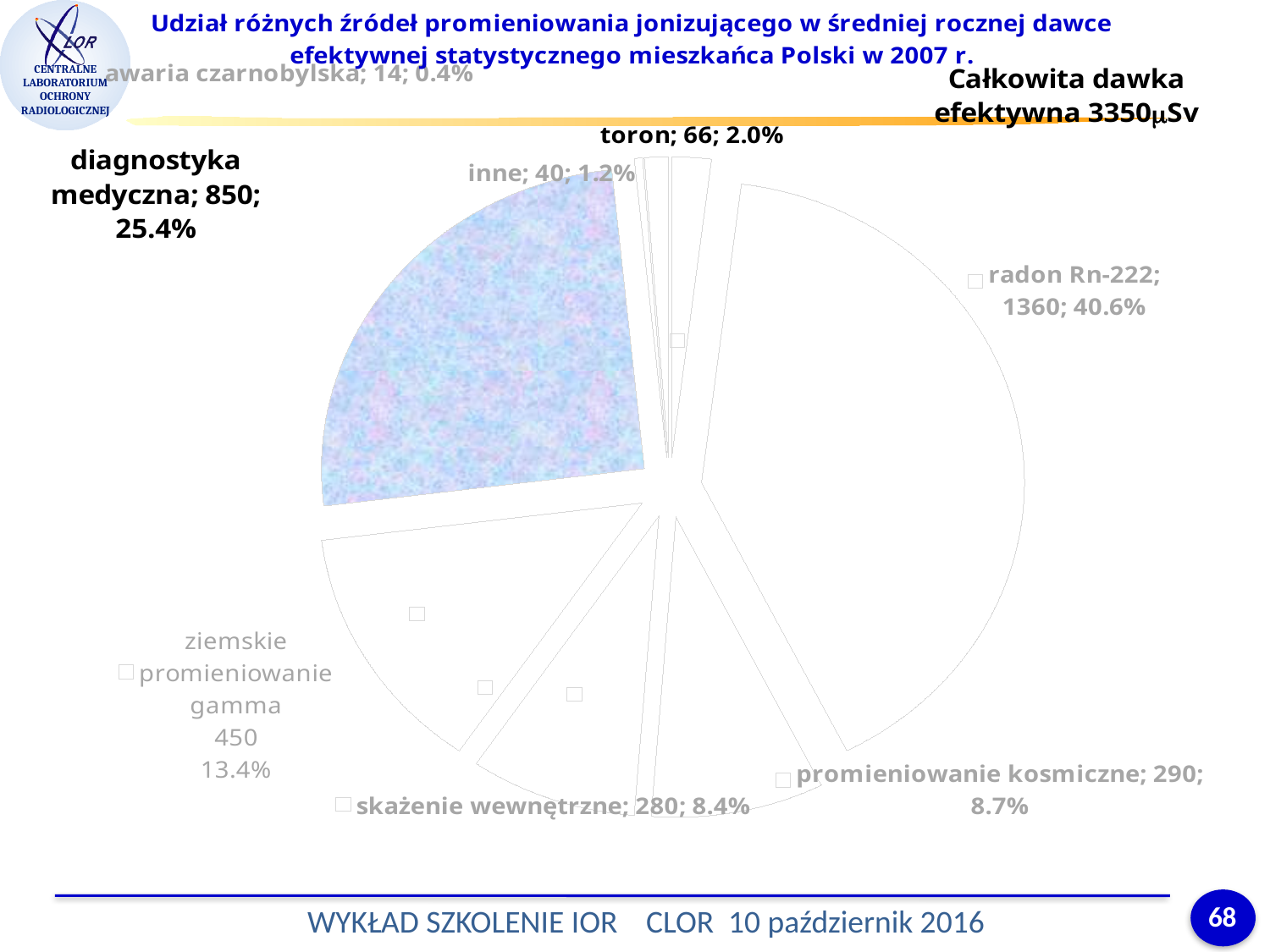
Which source has the largest share of the pie? radon Rn-222 What value is shown for promieniowanie kosmiczne? 290 How many slices does the pie chart have? 8 What percentage share is shown for diagnostyka medyczna? 25.4% What value is shown for radon Rn-222? 1360 What is the difference between the values for radon Rn-222 and diagnostyka medyczna? 510 What percentage share is shown for skażenie wewnętrzne? 8.4% What kind of chart is shown on the slide? pie chart Which source has the smallest share of the pie? awaria czarnobylska What total effective dose (Całkowita dawka efektywna) is stated on the slide? 3350 μSv Which is larger, the value for toron or the value for inne? toron What percentage share is shown for ziemskie promieniowanie gamma? 13.4%